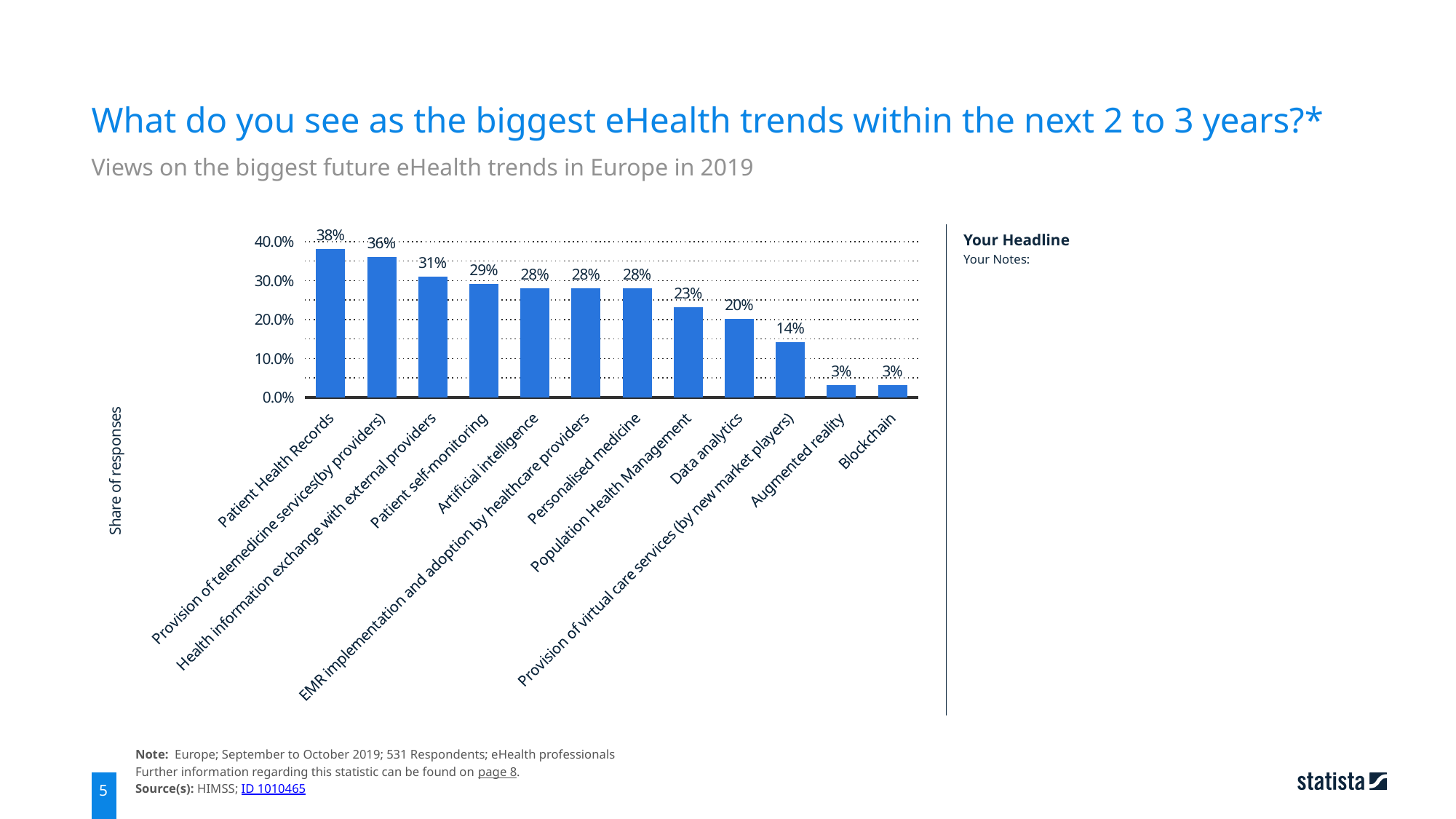
What kind of chart is shown on the slide? Bar chart What is the difference between the values for Population Health Management and Blockchain? 20% What is the value shown for Data analytics? 20% What is the difference between the values for Patient Health Records and Provision of telemedicine services (by providers)? 2% Is the value for Population Health Management greater or less than 20.0%? greater Which is larger, the value for Health information exchange with external providers or the value for Patient self-monitoring? Health information exchange with external providers What share of responses named Patient Health Records as a biggest eHealth trend? 38% Which category has the highest share of responses? Patient Health Records How many categories are shown in the chart? 12 What is the label of the vertical axis? Share of responses Do the values rise or fall from left to right along the x axis? Fall What share of responses is shown for Provision of virtual care services (by new market players)? 14%